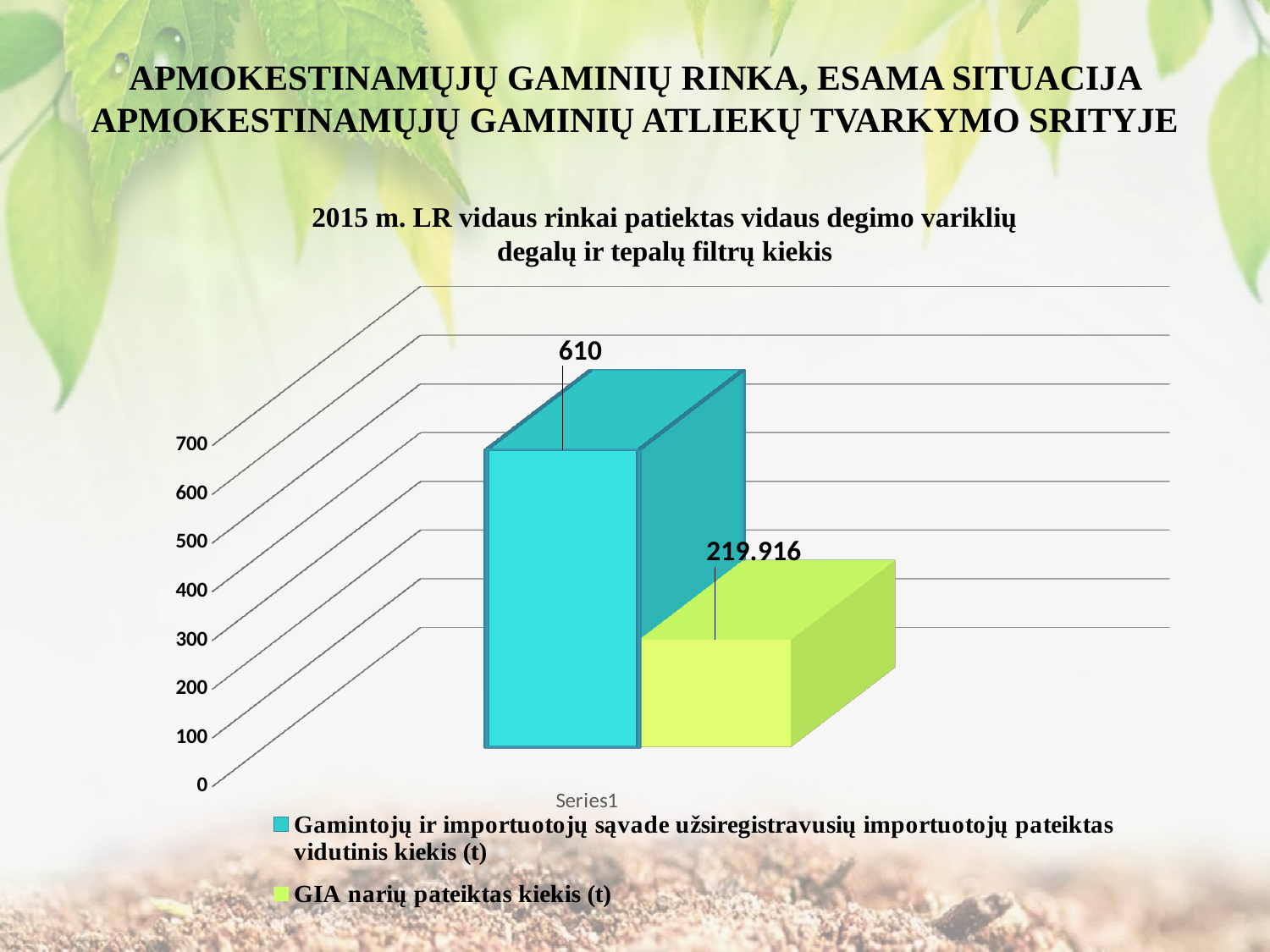
What is the category label shown on the x axis of the chart? Series1 Is the value for "GIA narių pateiktas kiekis (t)" greater or less than 300? less Is the value for "Gamintojų ir importuotojų sąvade užsiregistravusių importuotojų pateiktas vidutinis kiekis (t)" greater or less than 500? greater What is the title of the chart? 2015 m. LR vidaus rinkai patiektas vidaus degimo variklių degalų ir tepalų filtrų kiekis Which series has the lower value? GIA narių pateiktas kiekis (t) What is the difference between the value for "Gamintojų ir importuotojų sąvade užsiregistravusių importuotojų pateiktas vidutinis kiekis (t)" and the value for "GIA narių pateiktas kiekis (t)"? 390.084 What kind of chart is shown on the slide? bar chart What value is shown for the series "Gamintojų ir importuotojų sąvade užsiregistravusių importuotojų pateiktas vidutinis kiekis (t)"? 610 Which series has the higher value? Gamintojų ir importuotojų sąvade užsiregistravusių importuotojų pateiktas vidutinis kiekis (t) What value is shown for the series "GIA narių pateiktas kiekis (t)"? 219.916 How many series does the legend list? 2 Is the value for "GIA narių pateiktas kiekis (t)" larger or smaller than the value for "Gamintojų ir importuotojų sąvade užsiregistravusių importuotojų pateiktas vidutinis kiekis (t)"? smaller